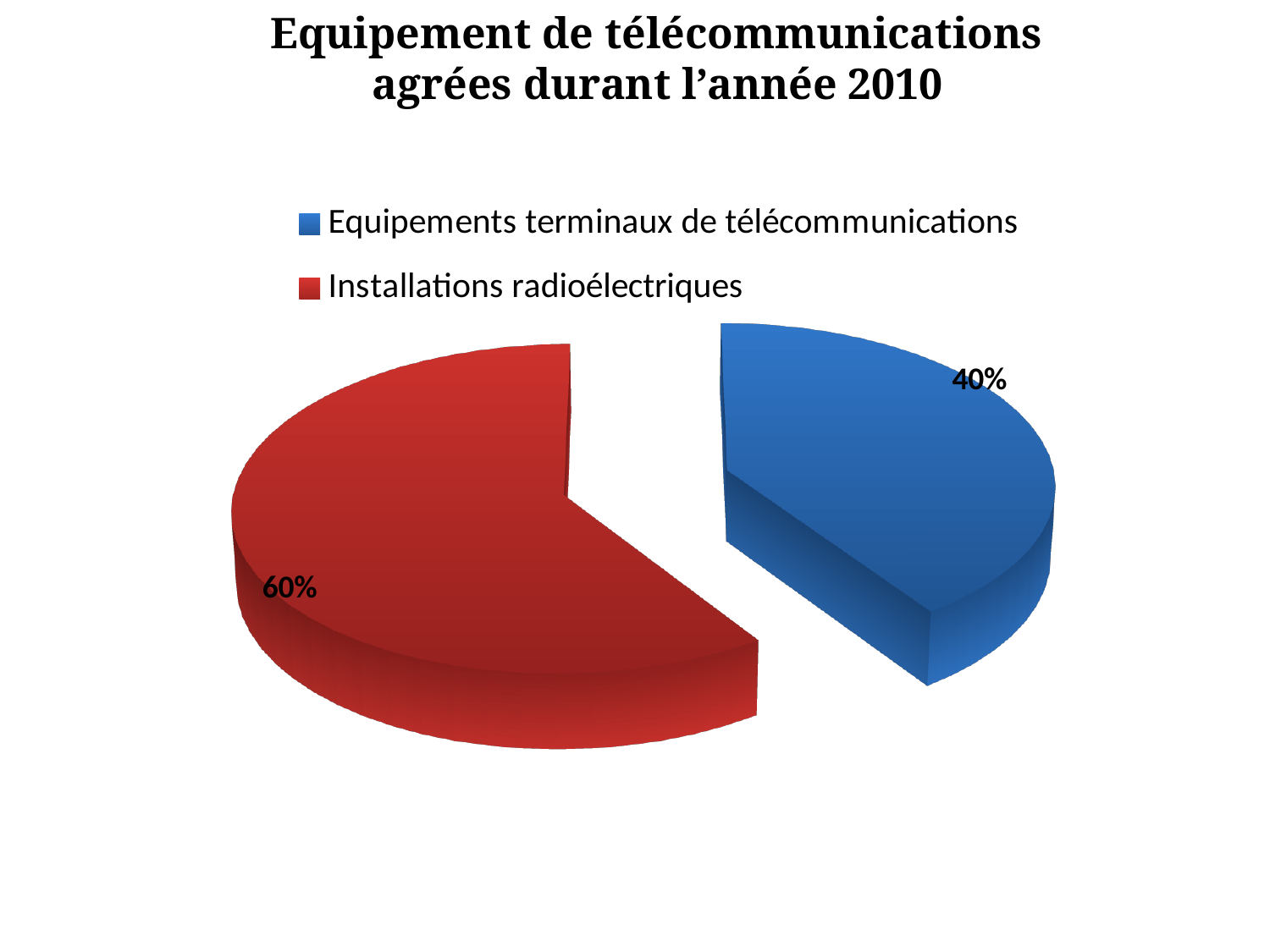
Which category has the smallest slice of the pie? Equipements terminaux de télécommunications How many entries does the legend list? 2 What share of the pie does Installations radioélectriques represent? 60% Which is larger: the slice for Installations radioélectriques or the slice for Equipements terminaux de télécommunications? Installations radioélectriques What kind of chart is shown on the slide? Pie chart What colour is the slice for Installations radioélectriques? Red What is the difference in percentage points between Installations radioélectriques and Equipements terminaux de télécommunications? 20% How many slices does the pie chart have? 2 What share of the pie does Equipements terminaux de télécommunications represent? 40% Which category has the largest slice of the pie? Installations radioélectriques What is the title of the chart? Equipement de télécommunications agrées durant l'année 2010